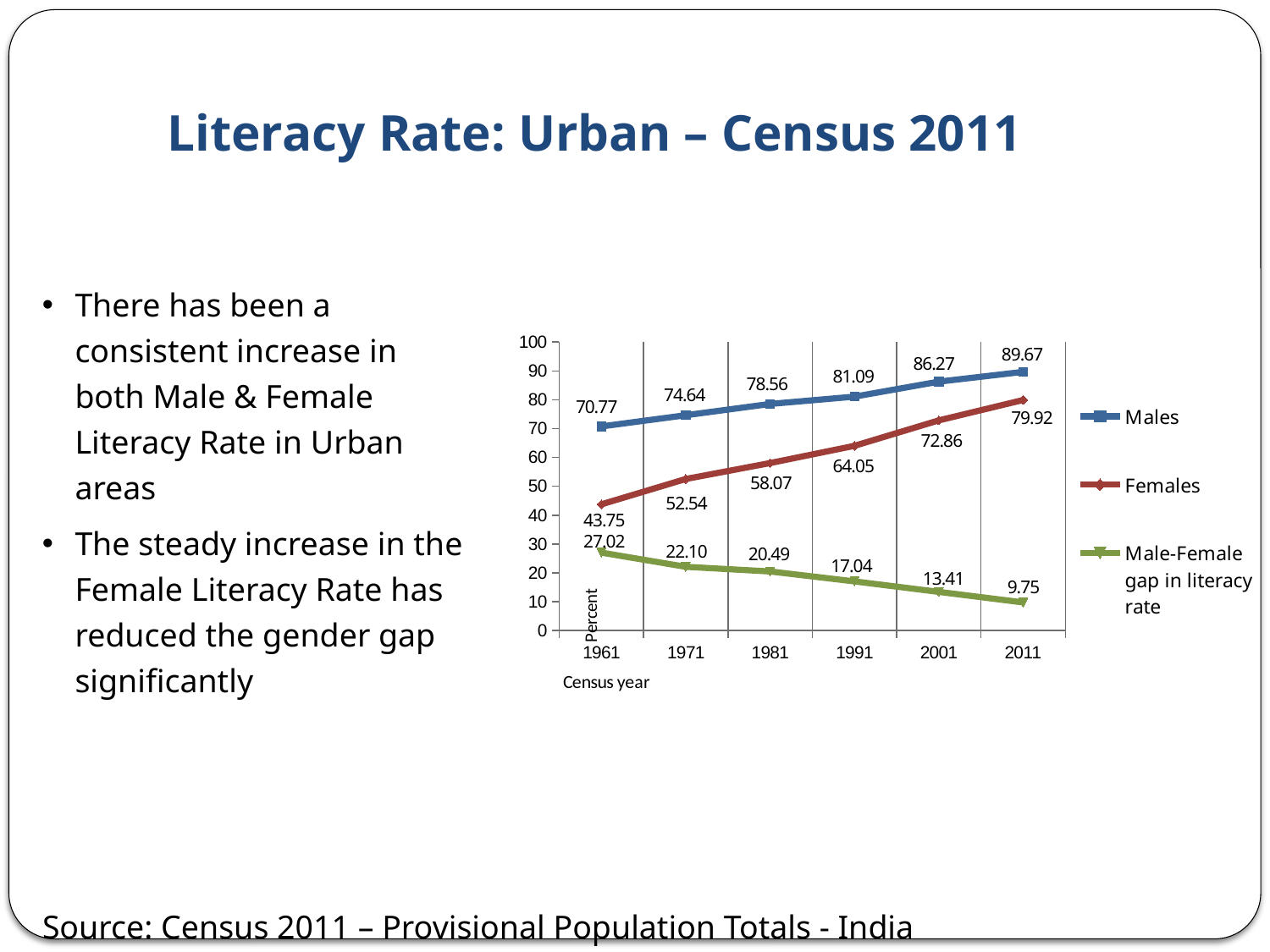
What is the Females literacy rate value for 1961? 43.75 Which is larger in 1981, the Males value or the Females value? Males In which census year is the Male-Female gap in literacy rate lowest? 2011 What is the difference between the Males and Females literacy rates in 2001? 13.41 In which census year is the Females literacy rate highest? 2011 Is the Females value for 1971 greater or less than 50? greater How many census years are plotted on the x axis? 6 What is the Male-Female gap in literacy rate for 1991? 17.04 How many series does the legend list? 3 What is the Males literacy rate value for 2011? 89.67 What kind of chart is shown on the slide? line chart Does the Male-Female gap in literacy rate rise or fall from 1961 to 2011? fall